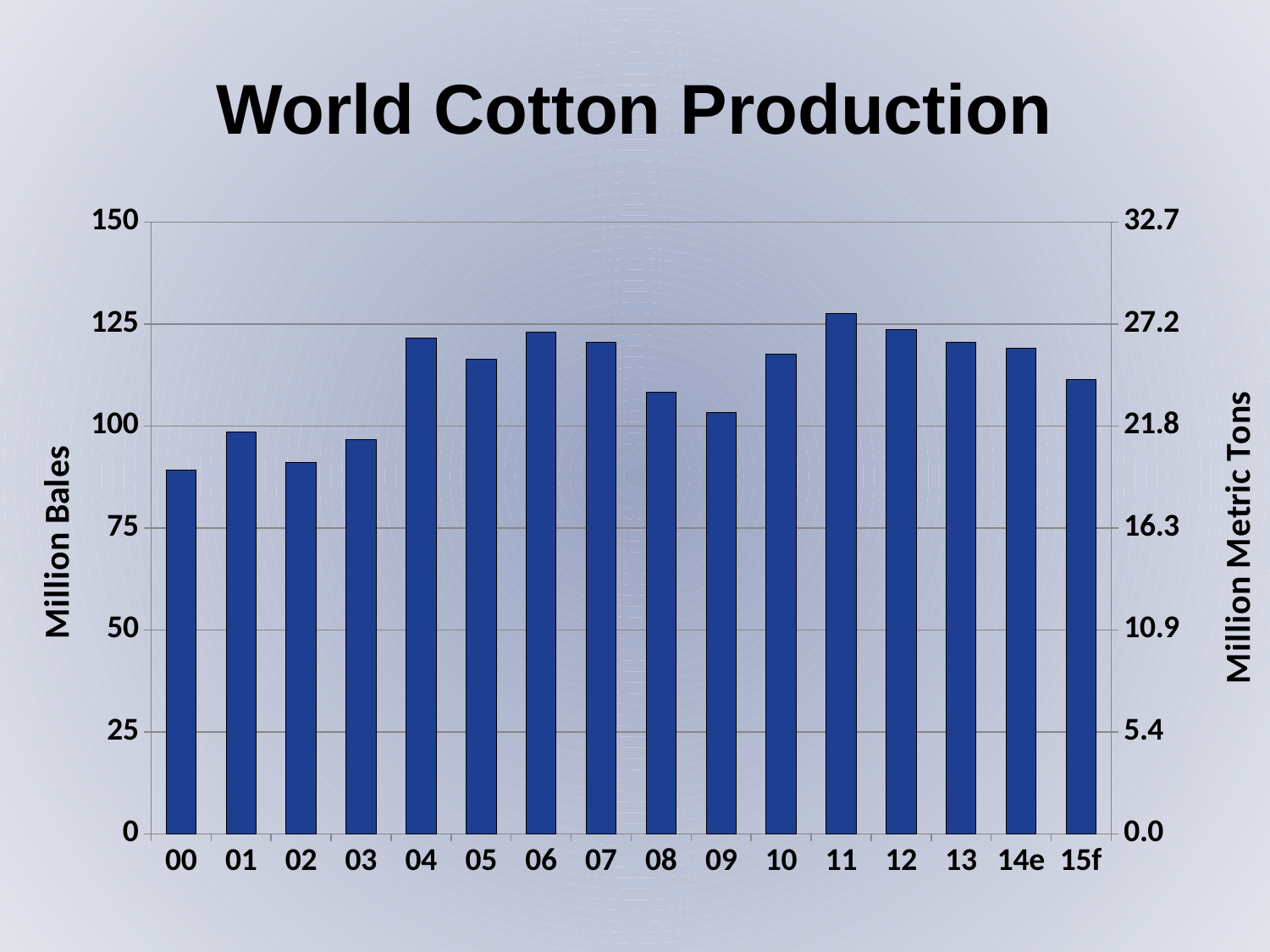
Which year has the highest world cotton production? 11 What kind of chart is shown on the slide? Bar chart Is the value for 04 greater or less than 100 million bales? greater Which is larger, the value for 06 or the value for 09? 06 Is the value for 00 greater or less than 100 million bales? less Is the value for 15f greater or less than 125 million bales? less Which year has the lowest world cotton production? 00 What is the label of the left vertical axis? Million Bales How many years (categories) are plotted on the x axis? 16 What is the title of the chart? World Cotton Production Which is larger, the value for 03 or the value for 04? 04